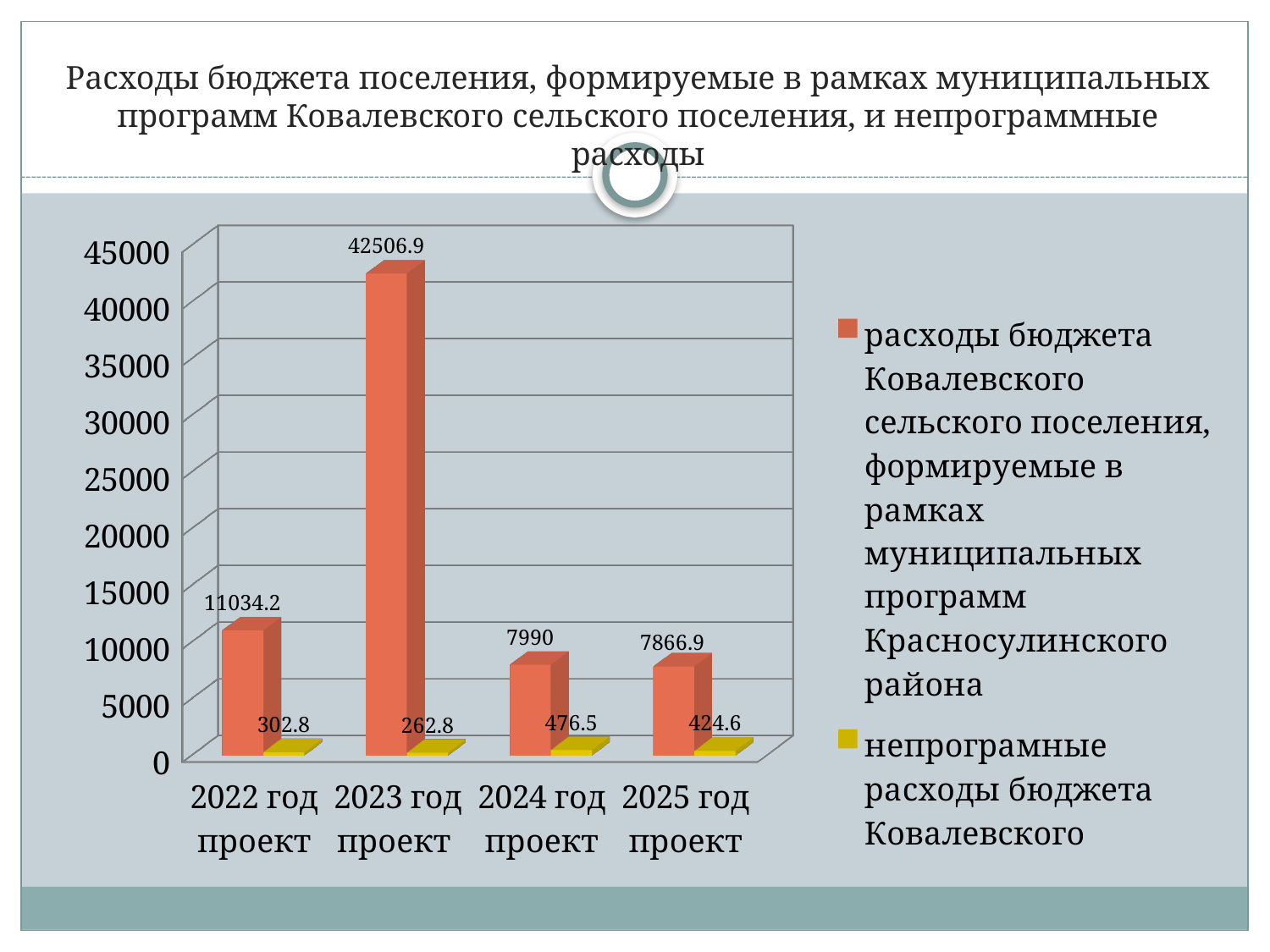
What type of chart is shown on the slide? bar chart Which colour represents непрограмные расходы in the legend? yellow What is the difference between the program budget expenses for 2023 год проект and 2022 год проект? 31472.7 What is the difference between непрограмные расходы for 2024 год проект and 2025 год проект? 51.9 In which year are the program budget expenses (orange bars) highest? 2023 год проект Which is larger: the program budget expenses for 2022 год проект or for 2024 год проект? 2022 год проект In which year are непрограмные расходы lowest? 2023 год проект What is the value of непрограмные расходы for 2024 год проект? 476.5 How many year categories are shown on the x axis? 4 What is the value of the program budget expenses for 2025 год проект? 7866.9 How many series does the legend list? 2 What is the value of the program budget expenses (расходы бюджета, формируемые в рамках муниципальных программ) for 2023 год проект? 42506.9